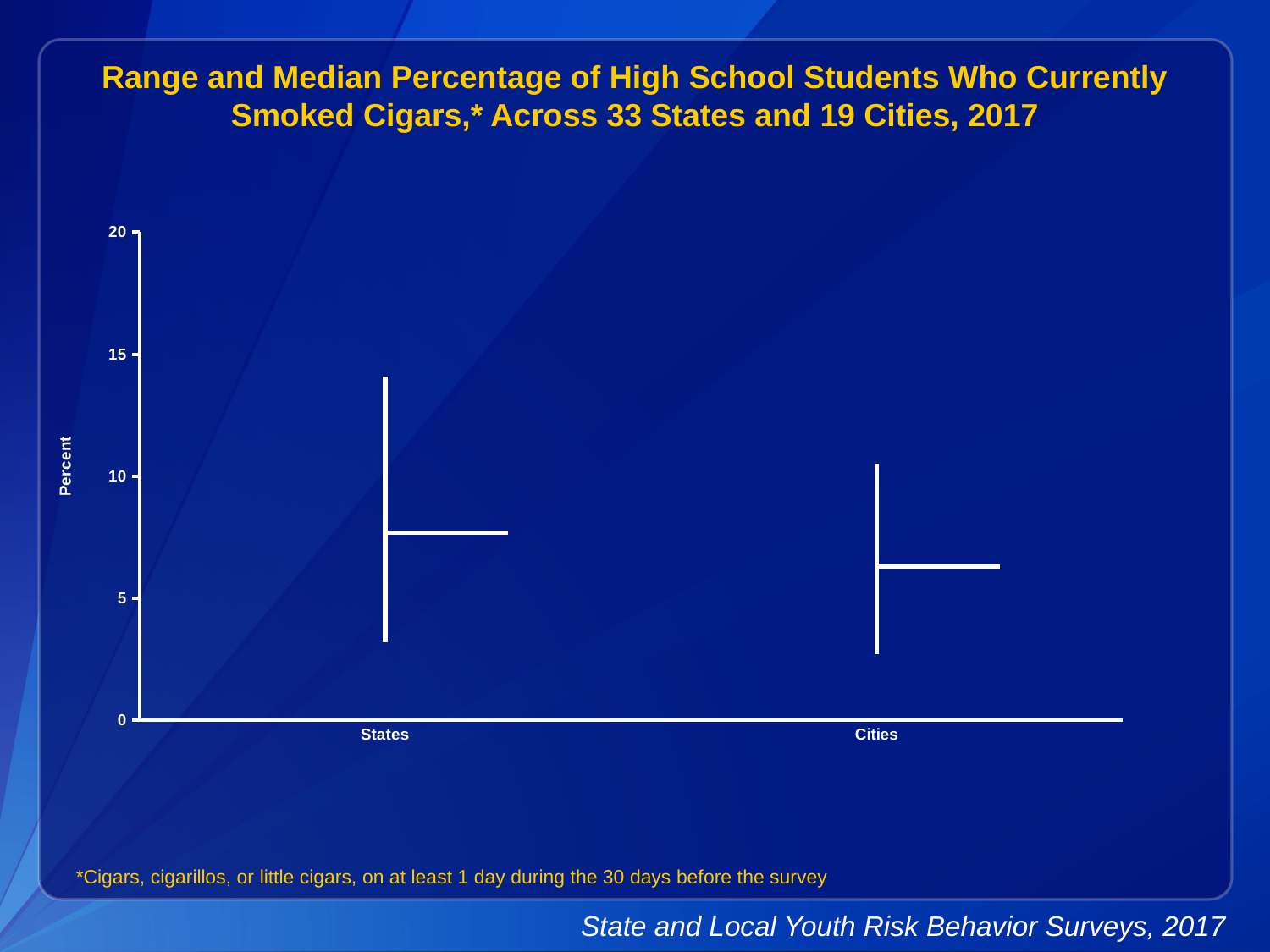
How many categories are shown on the x axis of the chart? 2 Is the top of the range for States greater or less than 10? greater What is the highest value shown on the y axis? 20 Is the median value for States greater or less than 5? greater Is the median value for States greater or less than 10? less What is the label of the y axis? Percent Which category has the higher median percentage, States or Cities? States What are the two categories shown on the x axis? States and Cities Which category has the higher top of its range? States